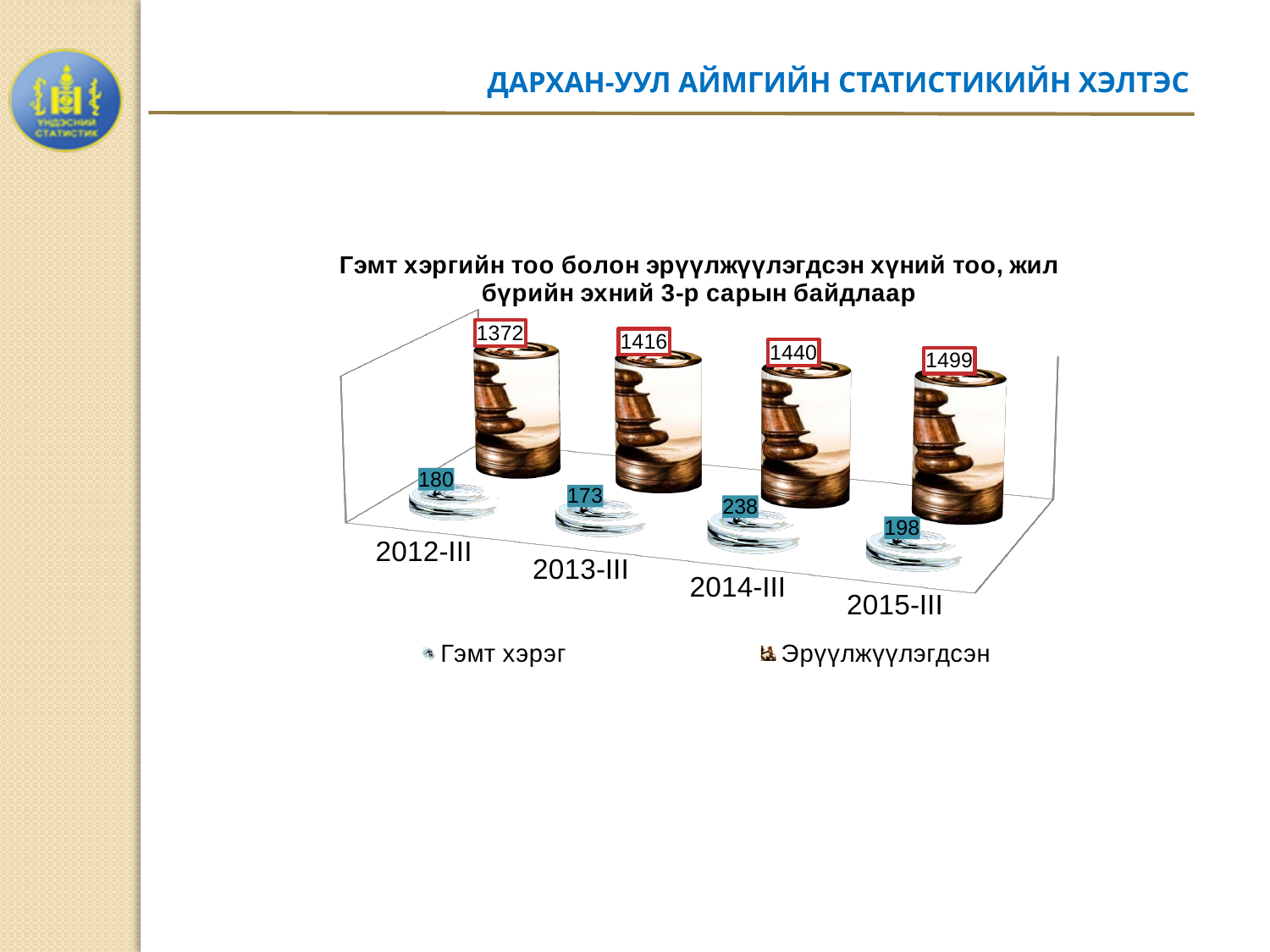
How many periods are shown on the x axis? 4 In which period is the Гэмт хэрэг value highest? 2014-III In which period is the Эрүүлжүүлэгдсэн value highest? 2015-III What is the value for Гэмт хэрэг in 2014-III? 238 How many series does the legend list? 2 What is the value for Гэмт хэрэг in 2013-III? 173 What is the value for Эрүүлжүүлэгдсэн in 2015-III? 1499 In which period is the Гэмт хэрэг value lowest? 2013-III Does the Эрүүлжүүлэгдсэн series rise or fall from 2012-III to 2015-III? rise What is the difference between the Эрүүлжүүлэгдсэн values for 2015-III and 2012-III? 127 What is the value for Эрүүлжүүлэгдсэн in 2012-III? 1372 Which is larger, the Гэмт хэрэг value for 2012-III or for 2015-III? 2015-III